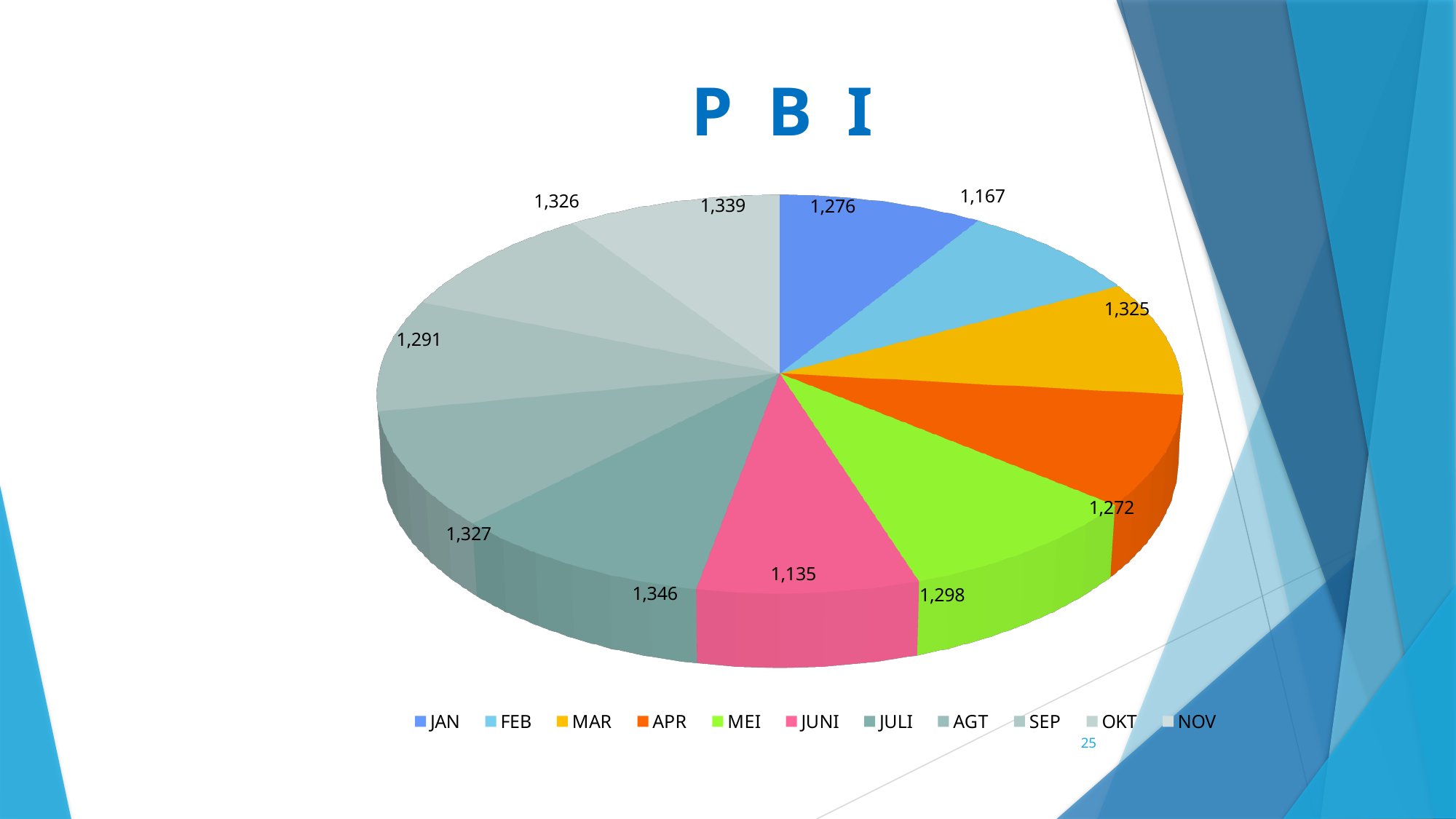
Which is larger, the value for MAR or the value for FEB? MAR What colour is the JUNI slice? Pink Which month has the lowest value? JUNI What is the difference between the values for JULI and JUNI? 211 What is the value for MAR? 1,325 What is the title of the chart? P B I What type of chart is shown on the slide? Pie chart Which month has the highest value? JULI What is the value for JAN? 1,276 How many categories does the legend list? 11 What is the value for NOV? 1,339 What is the value for JUNI? 1,135